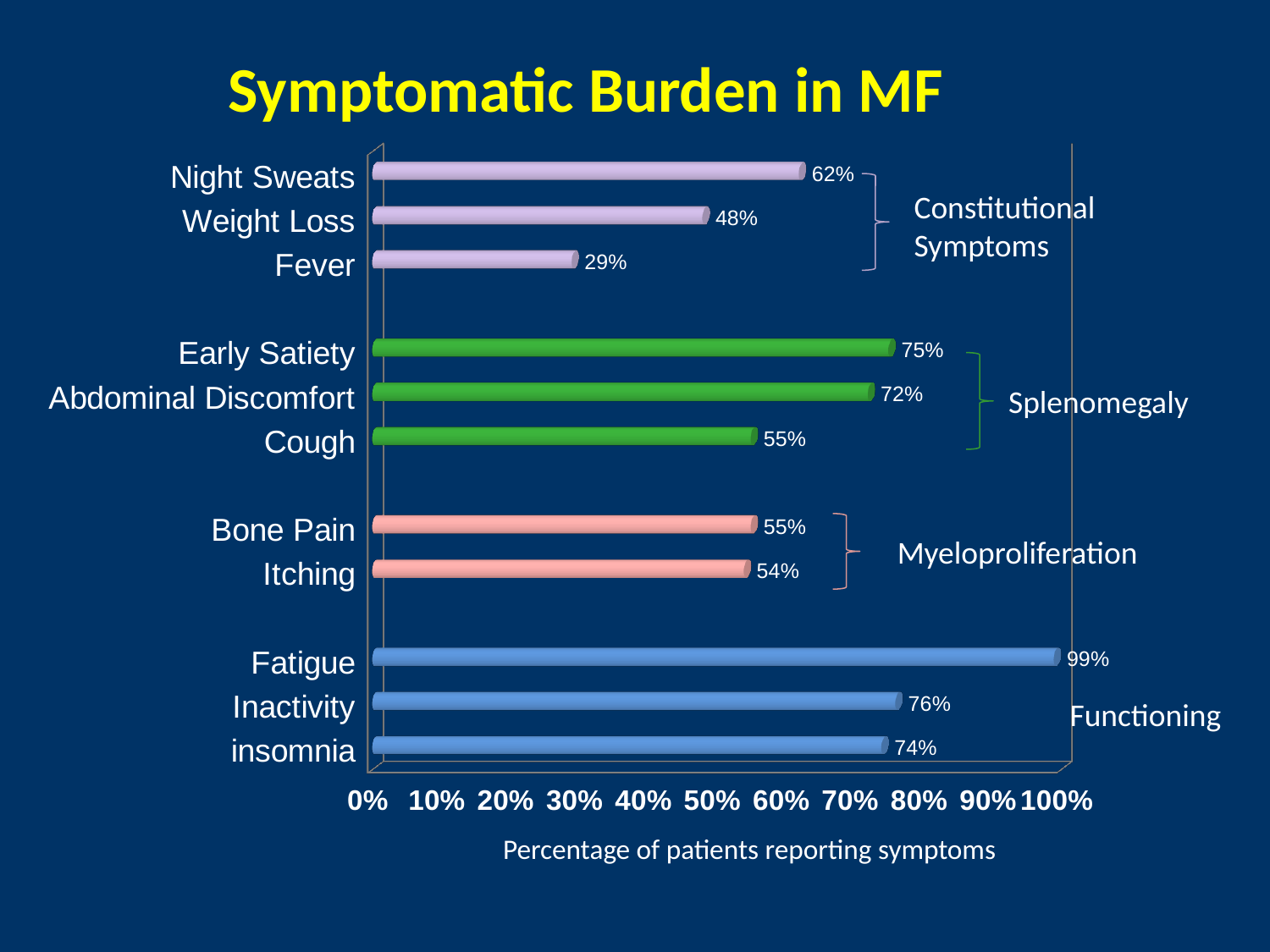
What is the title of the chart? Symptomatic Burden in MF Which symptom has the lowest percentage of patients reporting it? Fever Which is larger, the value for Inactivity or the value for insomnia? Inactivity What percentage of patients reported Fatigue? 99% What is the label of the horizontal axis? Percentage of patients reporting symptoms What kind of chart is shown on the slide? Bar chart What percentage of patients reported Night Sweats? 62% What is the difference between the percentages for Night Sweats and Weight Loss? 14% Which symptom has the highest percentage of patients reporting it? Fatigue What is the difference between the percentages for Early Satiety and Cough? 20% How many symptoms are plotted in the chart? 11 What is the value shown for Abdominal Discomfort? 72%